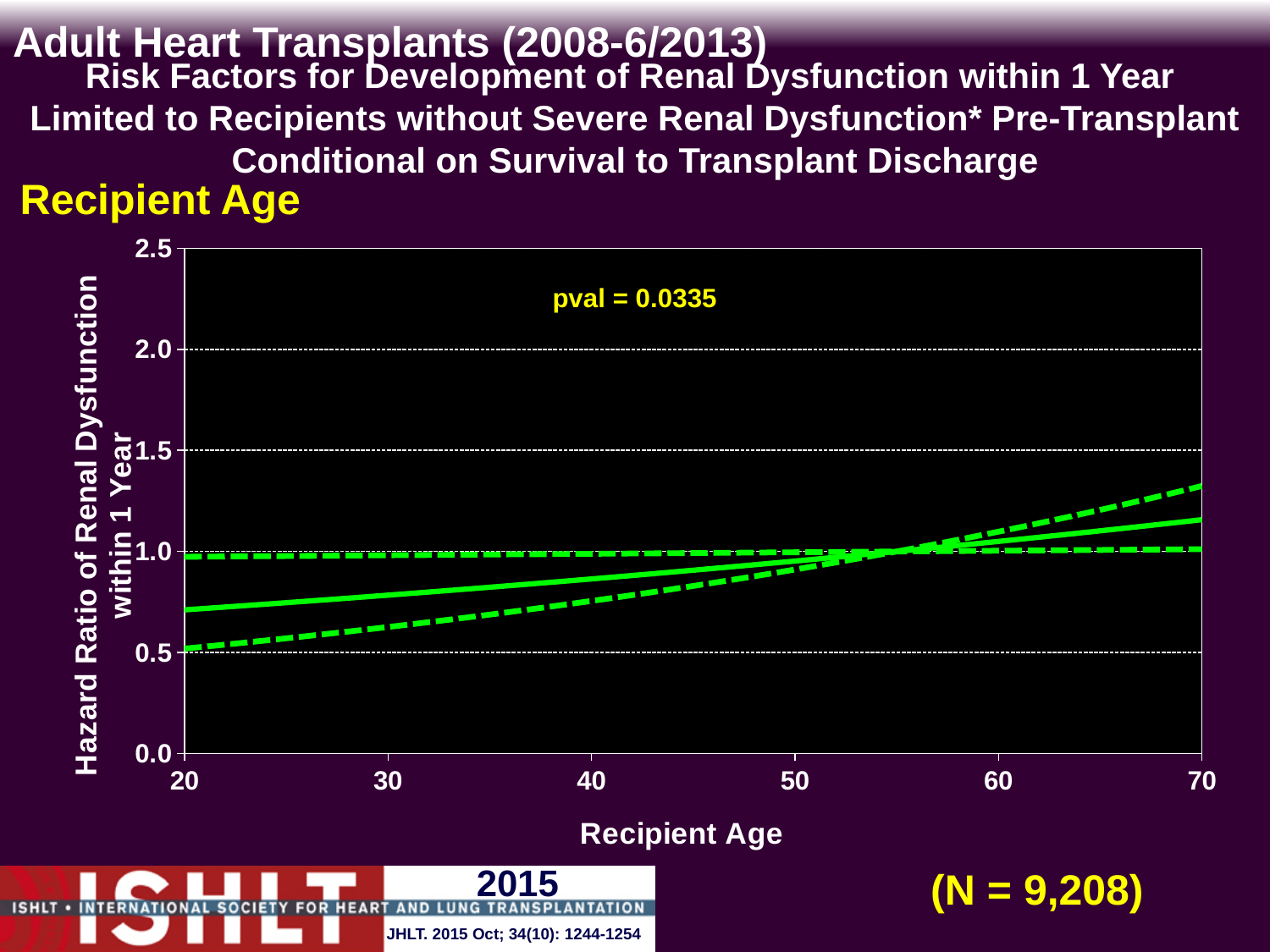
What kind of chart is shown on the slide? line chart Is the solid-line hazard ratio at recipient age 70 greater or less than 1.0? greater Is the solid-line hazard ratio at recipient age 20 greater or less than 1.0? less Which is larger: the solid-line hazard ratio at age 20 or at age 70? age 70 What is the highest value shown on the y axis? 2.5 What is the sample size N shown on the slide? N = 9,208 Is the lower dashed line at recipient age 20 greater or less than 1.0? less How many lines are plotted on the chart? 3 What is the label of the x axis? Recipient Age What p-value is printed on the chart? pval = 0.0335 Does the solid hazard ratio line rise or fall as recipient age increases from 20 to 70? rises